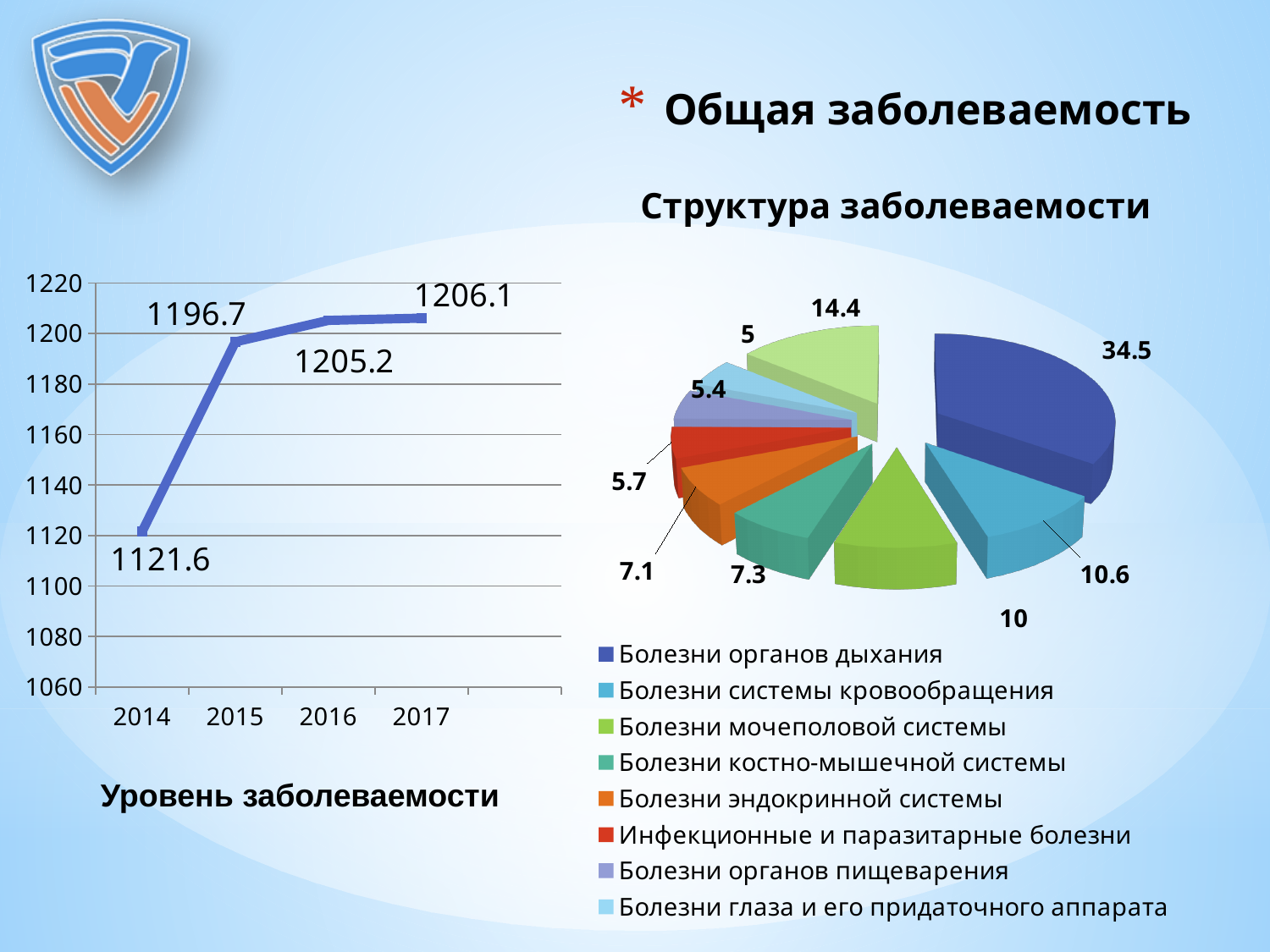
How many entries does the legend of the pie chart 'Структура заболеваемости' list? 8 On the line chart 'Уровень заболеваемости', what is the value for 2017? 1206.1 On the pie chart 'Структура заболеваемости', which is larger: Болезни системы кровообращения or Болезни мочеполовой системы? Болезни системы кровообращения On the line chart 'Уровень заболеваемости', which year has the lowest value? 2014 What kind of chart is 'Уровень заболеваемости'? line chart On the line chart 'Уровень заболеваемости', do the values rise or fall from 2014 to 2017? rise On the line chart 'Уровень заболеваемости', how many years are plotted? 4 On the pie chart 'Структура заболеваемости', what is the value for Болезни органов дыхания? 34.5 On the line chart 'Уровень заболеваемости', what is the difference between the 2015 and 2014 values? 75.1 On the pie chart 'Структура заболеваемости', which legend category has the largest slice? Болезни органов дыхания On the line chart 'Уровень заболеваемости', what is the value for 2014? 1121.6 On the pie chart 'Структура заболеваемости', what is the value for Болезни эндокринной системы? 7.1